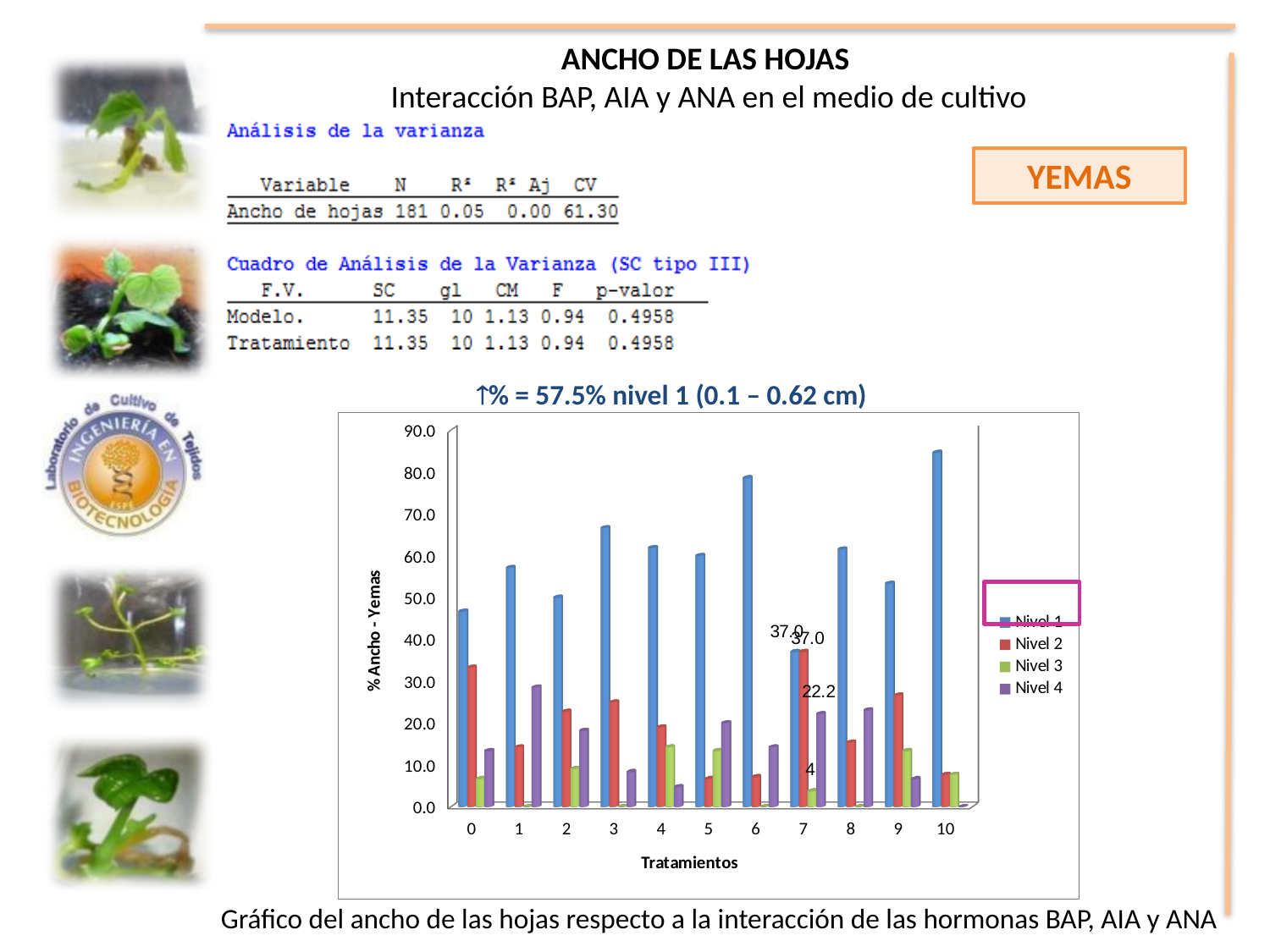
What is the title of the vertical axis of the chart? % Ancho - Yemas What is the value of Nivel 3 for treatment 7? 4 What is the value of Nivel 1 for treatment 7? 37.0 How many series does the chart legend list? 4 Is the Nivel 1 value for treatment 10 greater or less than 80.0? greater What kind of chart is shown on the slide? bar chart How many treatment categories are shown on the x axis of the chart? 11 What is the difference between the Nivel 1 value and the Nivel 3 value for treatment 7? 33 For which treatment is the Nivel 1 value lowest? 7 Which is larger, the Nivel 1 value for treatment 6 or the Nivel 1 value for treatment 3? treatment 6 For which treatment is the Nivel 1 value highest? 10 What is the value of Nivel 4 for treatment 7? 22.2